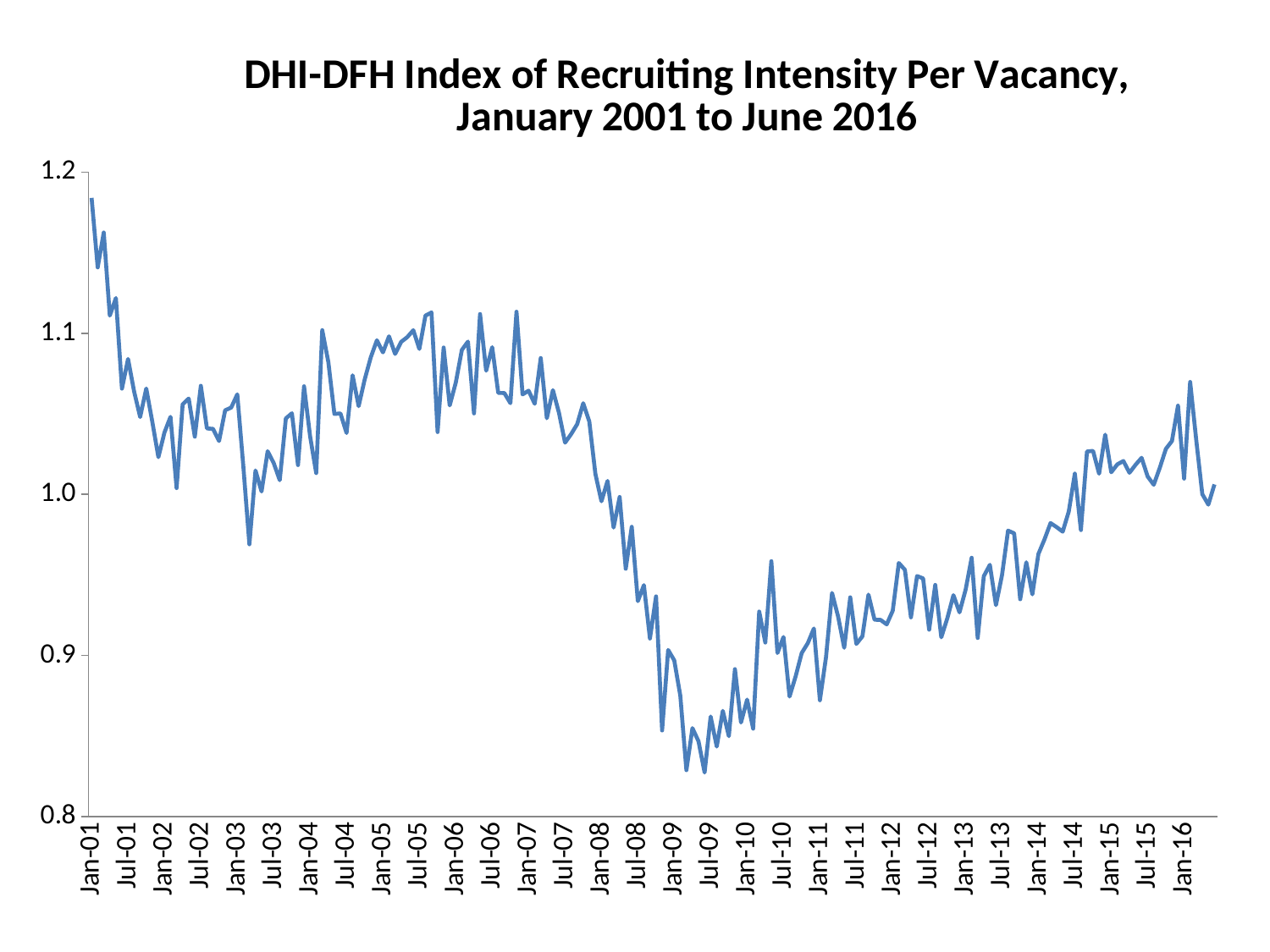
Which is larger, the index value at Jan-01 or at Jul-09? Jan-01 Does the index generally rise or fall between Jan-07 and Jul-09? fall In which year does the index reach its highest point? 2001 Does the index generally rise or fall between Jul-09 and Jan-16? rise Is the value of the index at Jul-09 greater or less than 0.9? less What kind of chart is shown on the slide? line chart In which year does the index reach its lowest point? 2009 Is the value of the index at Jan-05 greater or less than 1.0? greater Is the value of the index at Jan-12 greater or less than 1.0? less How many data series are plotted on the chart? 1 What is the title of the chart? DHI-DFH Index of Recruiting Intensity Per Vacancy, January 2001 to June 2016